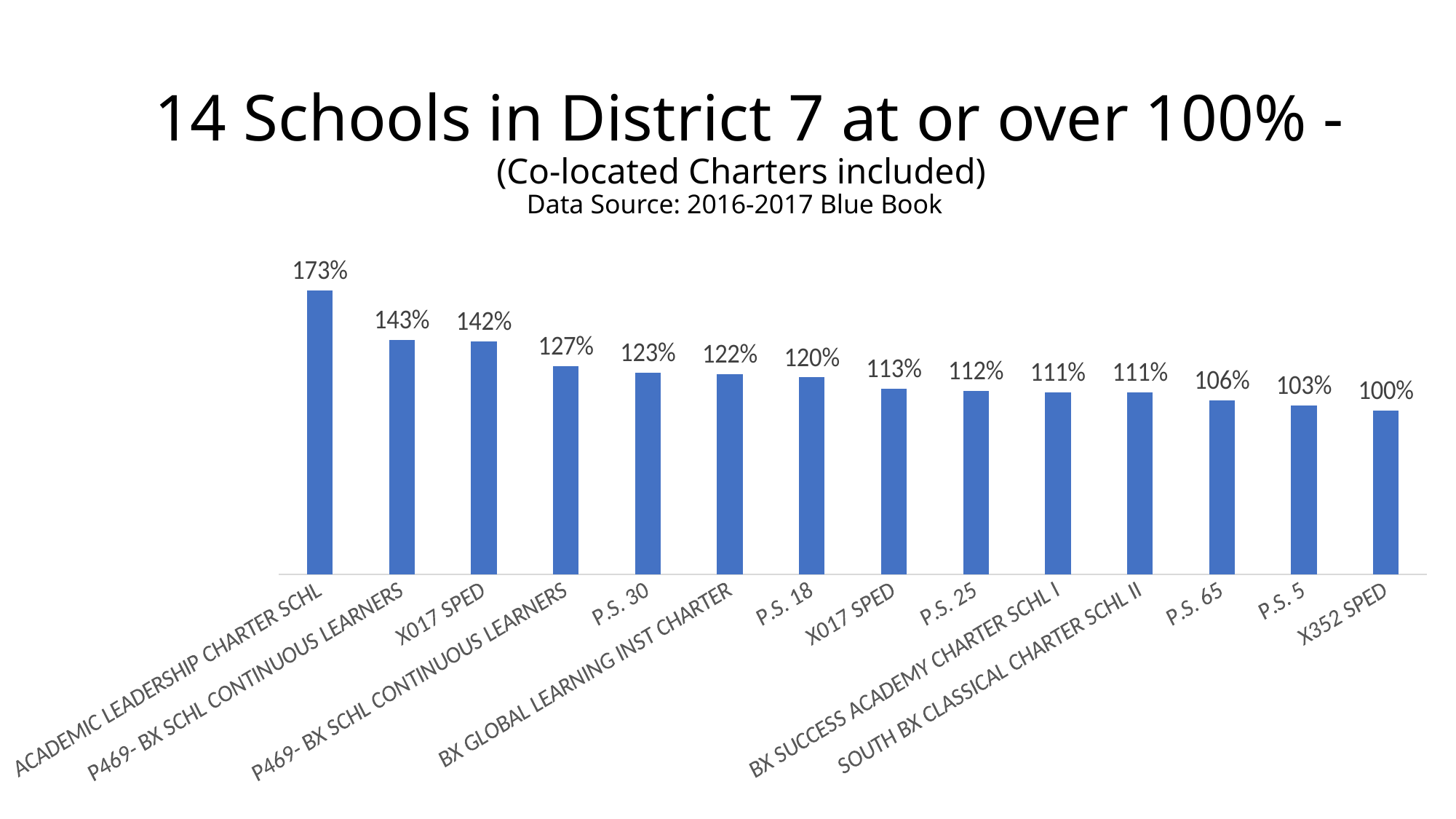
What is the value for P.S. 30? 123% Which school has the highest value? ACADEMIC LEADERSHIP CHARTER SCHL What kind of chart is shown on the slide? Bar chart Do the values rise or fall from left to right across the chart? Fall Which school has the lowest value? X352 SPED How many schools are shown in the chart? 14 What is the difference between the values for ACADEMIC LEADERSHIP CHARTER SCHL and P.S. 5? 70% Which has a larger value, P.S. 18 or P.S. 25? P.S. 18 What is the value for ACADEMIC LEADERSHIP CHARTER SCHL? 173% What is the value for P.S. 65? 106% What is the value for X352 SPED? 100% What is the value for BX GLOBAL LEARNING INST CHARTER? 122%